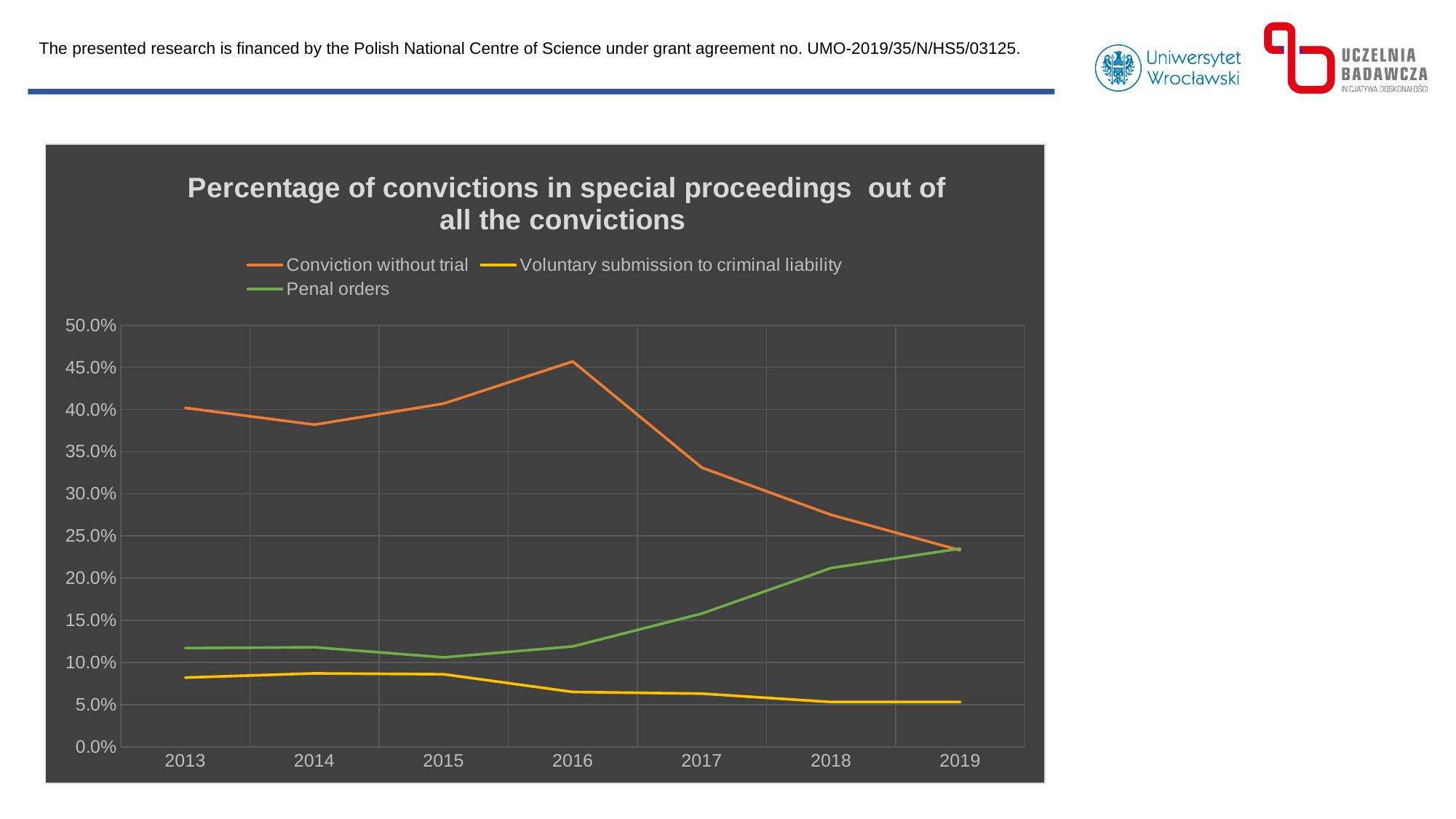
What kind of chart is shown on the slide? line chart Is the value for Voluntary submission to criminal liability in 2019 greater or less than 10.0%? less Is the value for Conviction without trial in 2016 greater or less than 40.0%? greater In 2013, which series has the larger value: Conviction without trial or Penal orders? Conviction without trial Does the Penal orders series rise or fall from 2015 to 2019? rise In which year does the Conviction without trial series reach its highest value? 2016 Is the value for Penal orders in 2013 greater or less than 10.0%? greater How many years are plotted along the x axis? 7 In which year does the Conviction without trial series reach its lowest value? 2019 In which year does the Penal orders series reach its highest value? 2019 In which year does the Penal orders series reach its lowest value? 2015 How many series does the legend list? 3